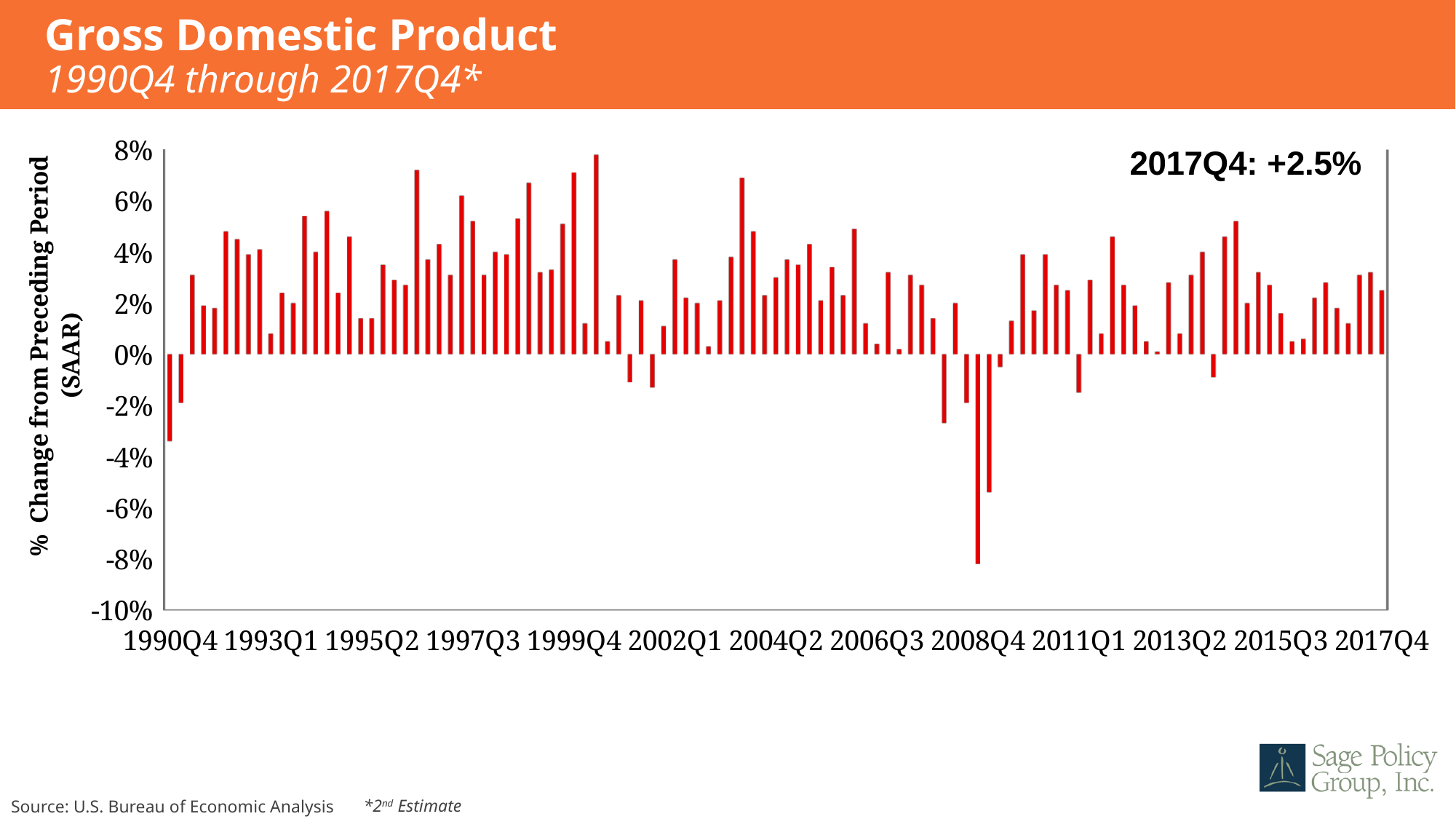
How many period labels are shown along the x axis? 13 What is the value for 2017Q4? +2.5% Is the value for 2017Q4 greater or less than 2%? greater What kind of chart is shown on the slide? bar chart Which is larger, the value for 1990Q4 or the value for 2017Q4? 2017Q4 Is the value for 2017Q4 greater or less than 4%? less What is the label on the y axis? % Change from Preceding Period (SAAR) Is the lowest bar on the chart greater or less than -6%? less What is the title of the chart? Gross Domestic Product